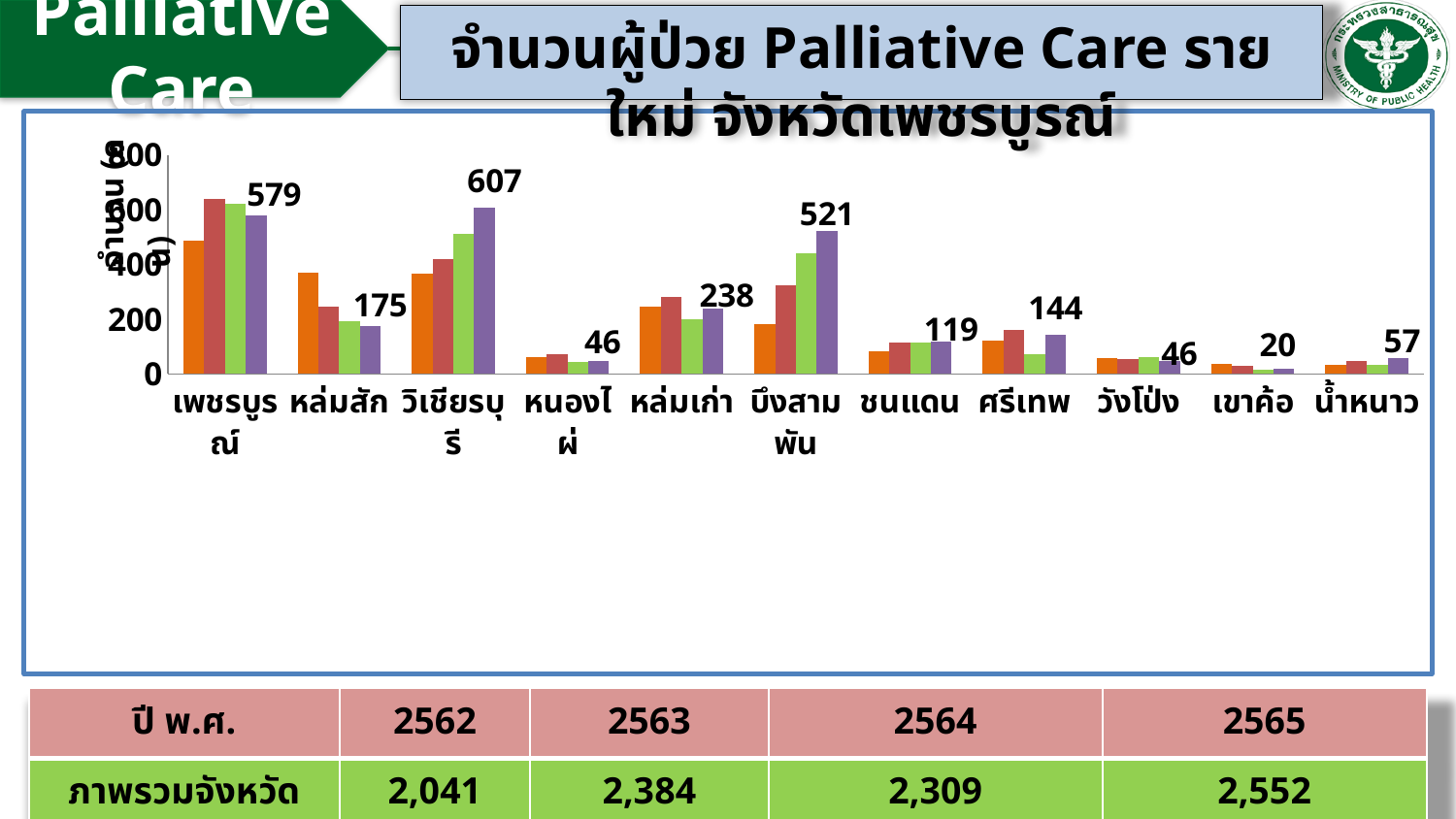
How many districts are shown on the x axis of the chart? 11 What is the labeled value for เขาค้อ? 20 Which has the larger labeled value, ศรีเทพ or ชนแดน? ศรีเทพ What kind of chart is shown on the slide? bar chart Which district has the highest labeled value? วิเชียรบุรี What is the difference between the labeled values for บึงสามพัน and หล่มเก่า? 283 Is the value of the orange bar for เพชรบูรณ์ greater or less than 400? greater Is the value of the orange bar for หล่มสัก greater or less than 200? greater What is the difference between the labeled values for วิเชียรบุรี and เพชรบูรณ์? 28 What is the labeled value for วิเชียรบุรี? 607 What is the labeled value for น้ำหนาว? 57 Which district has the lowest labeled value? เขาค้อ